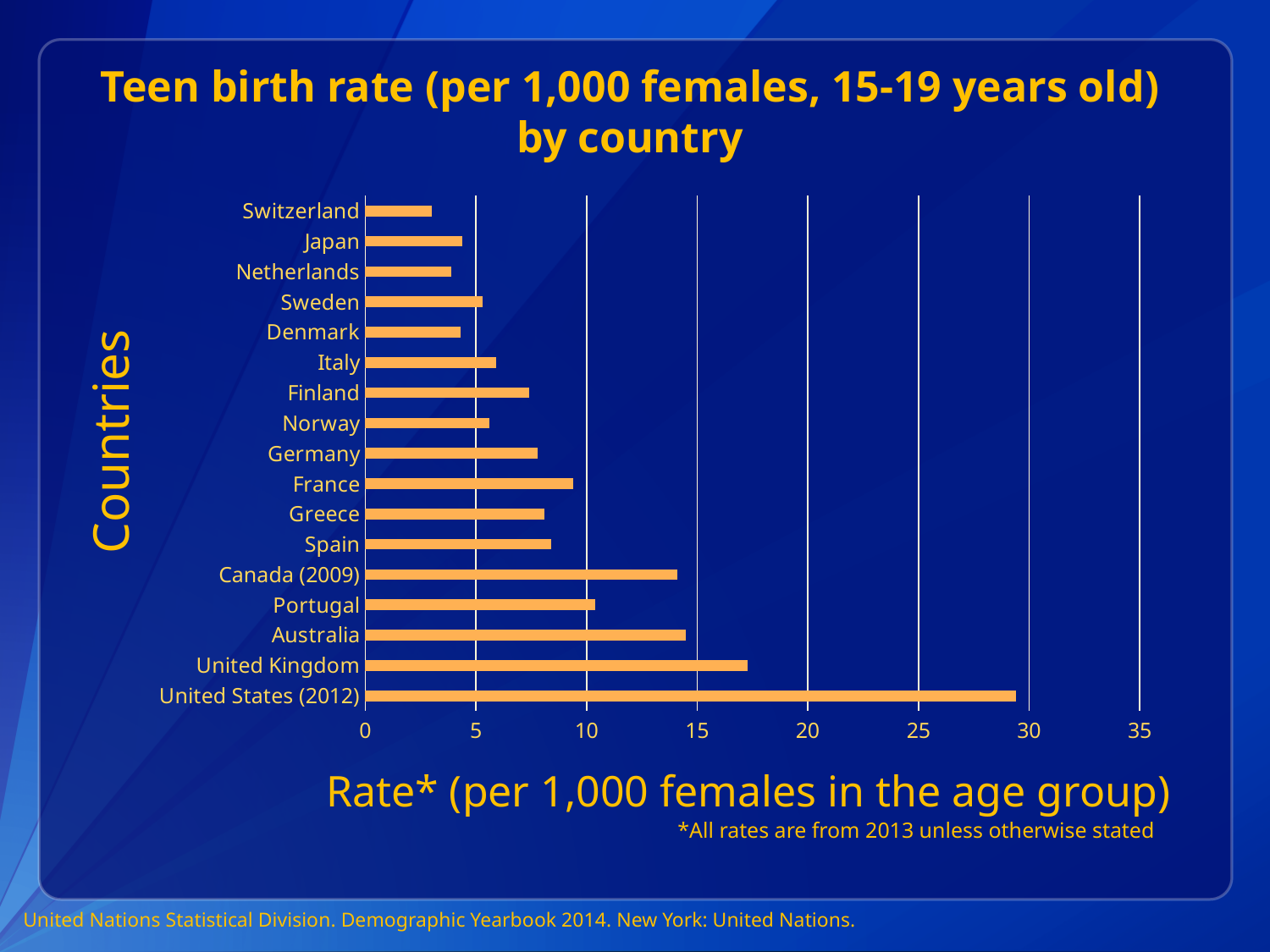
How many countries are plotted in the chart? 17 Which has the larger teen birth rate, Canada (2009) or Portugal? Canada (2009) What kind of chart is shown on the slide? bar chart Which country has the highest teen birth rate in the chart? United States (2012) What is the label on the horizontal axis of the chart? Rate* (per 1,000 females in the age group) Which has the larger teen birth rate, United Kingdom or Australia? United Kingdom Is the value for United Kingdom greater or less than 15? greater Which country has the lowest teen birth rate in the chart? Switzerland Is the value for United States (2012) greater or less than 25? greater Is the value for Switzerland greater or less than 5? less